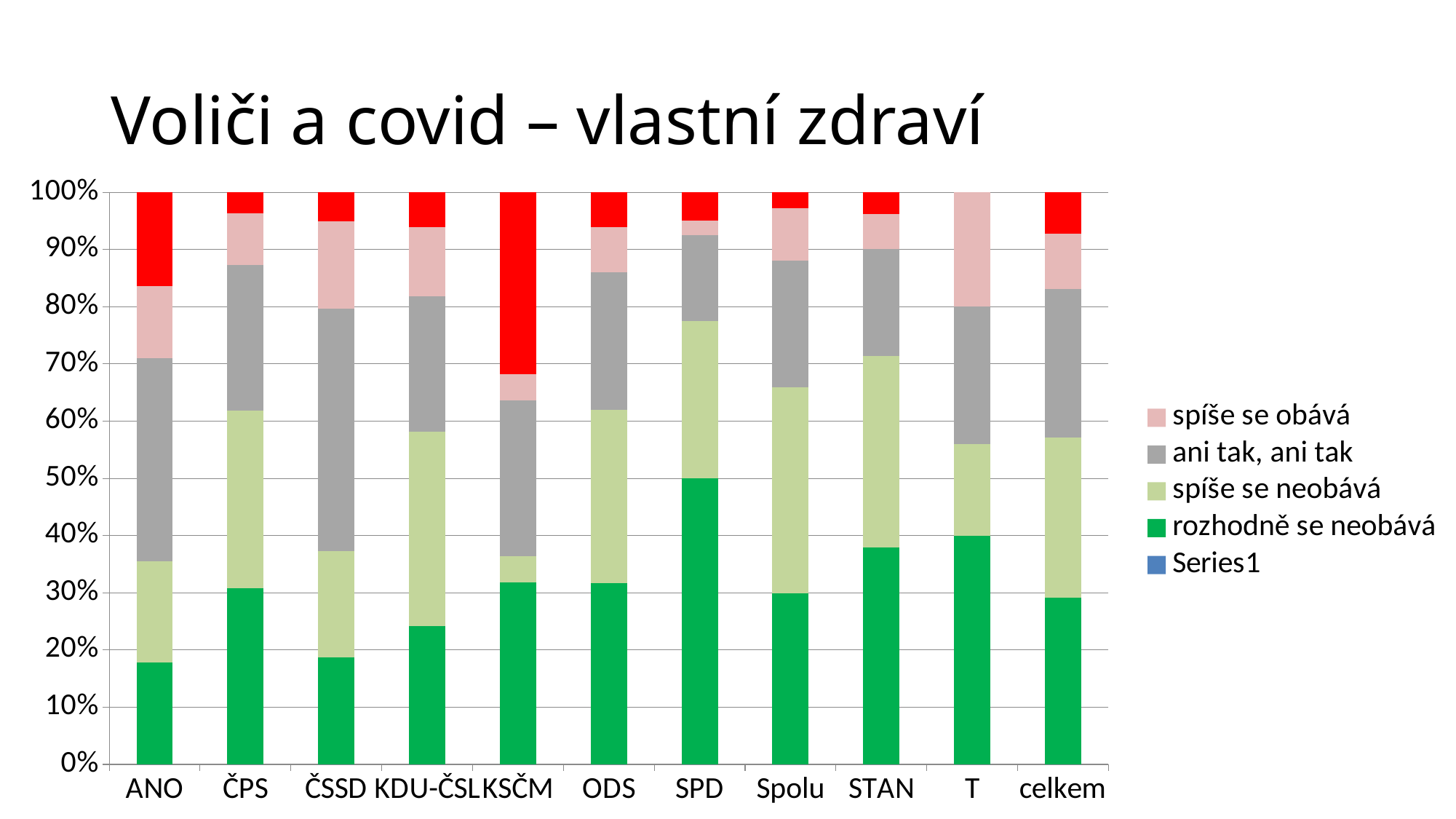
What is the title of the chart on the slide? Voliči a covid – vlastní zdraví Is the value for 'rozhodně se neobává' for SPD greater or less than 40%? greater What colour represents 'rozhodně se neobává' in the legend? Green What kind of chart is shown on the slide? Stacked bar chart Which category has the highest value for 'rozhodně se neobává'? SPD How many categories are shown on the x axis of the chart? 11 Which category has the largest red (top) segment in its bar? KSČM How many series does the chart's legend list? 5 Is the value for 'rozhodně se neobává' for ANO greater or less than 20%? less Which is larger, the 'rozhodně se neobává' value for ČPS or for KDU-ČSL? ČPS Is the value for 'rozhodně se neobává' for KDU-ČSL greater or less than 30%? less